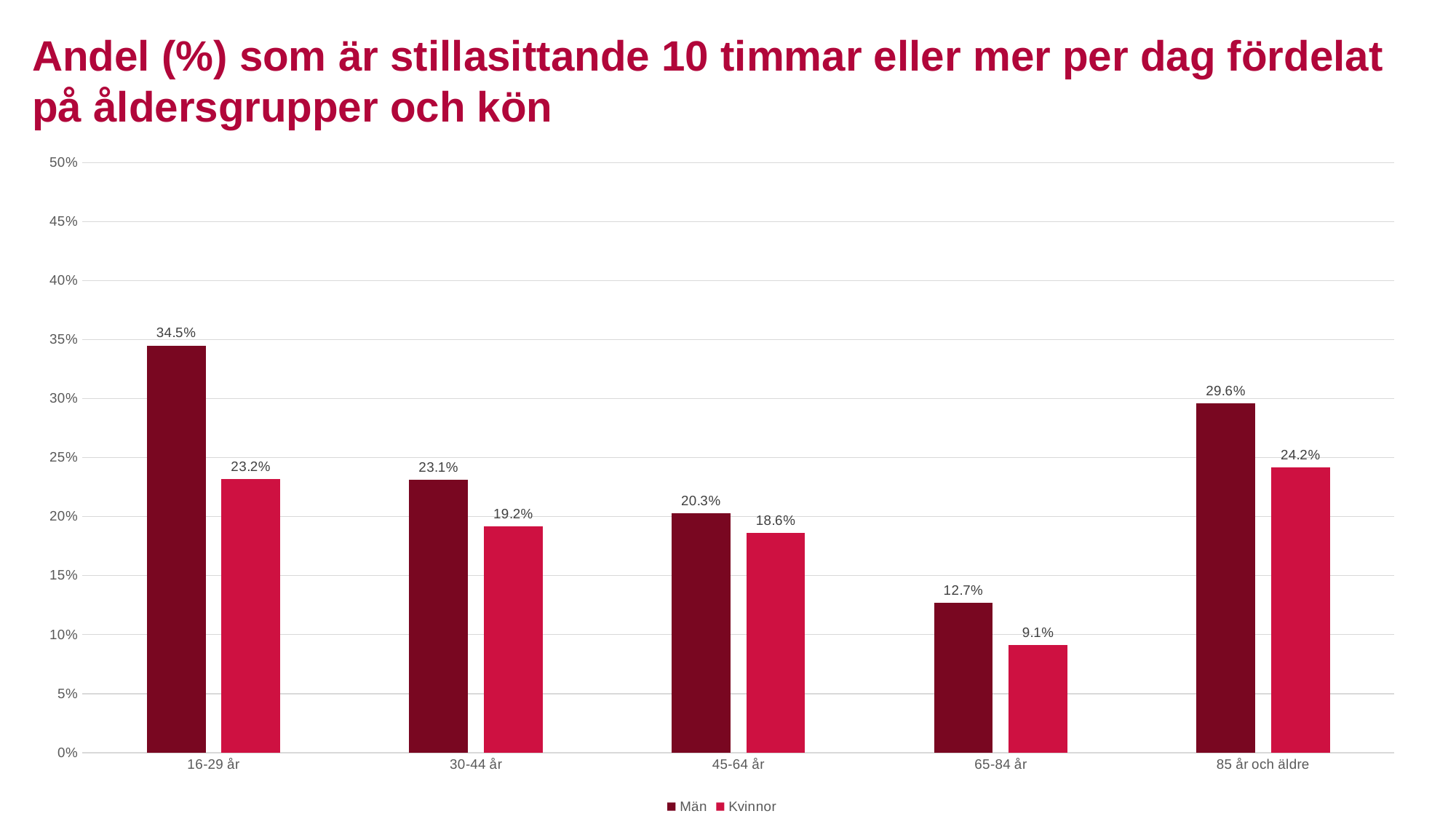
Which age group has the highest value for Män? 16-29 år How many series does the legend list? 2 What is the value for Kvinnor in the 85 år och äldre age group? 24.2% Which series is shown in the darker colour in the legend? Män Which is larger in the 85 år och äldre age group, Män or Kvinnor? Män What is the difference between Män and Kvinnor in the 16-29 år age group? 11.3% What is the value for Kvinnor in the 65-84 år age group? 9.1% What is the value for Män in the 16-29 år age group? 34.5% How many age groups are shown on the x axis? 5 Which age group has the lowest value for Kvinnor? 65-84 år What kind of chart is shown on the slide? Bar chart What is the difference between Män and Kvinnor in the 45-64 år age group? 1.7%